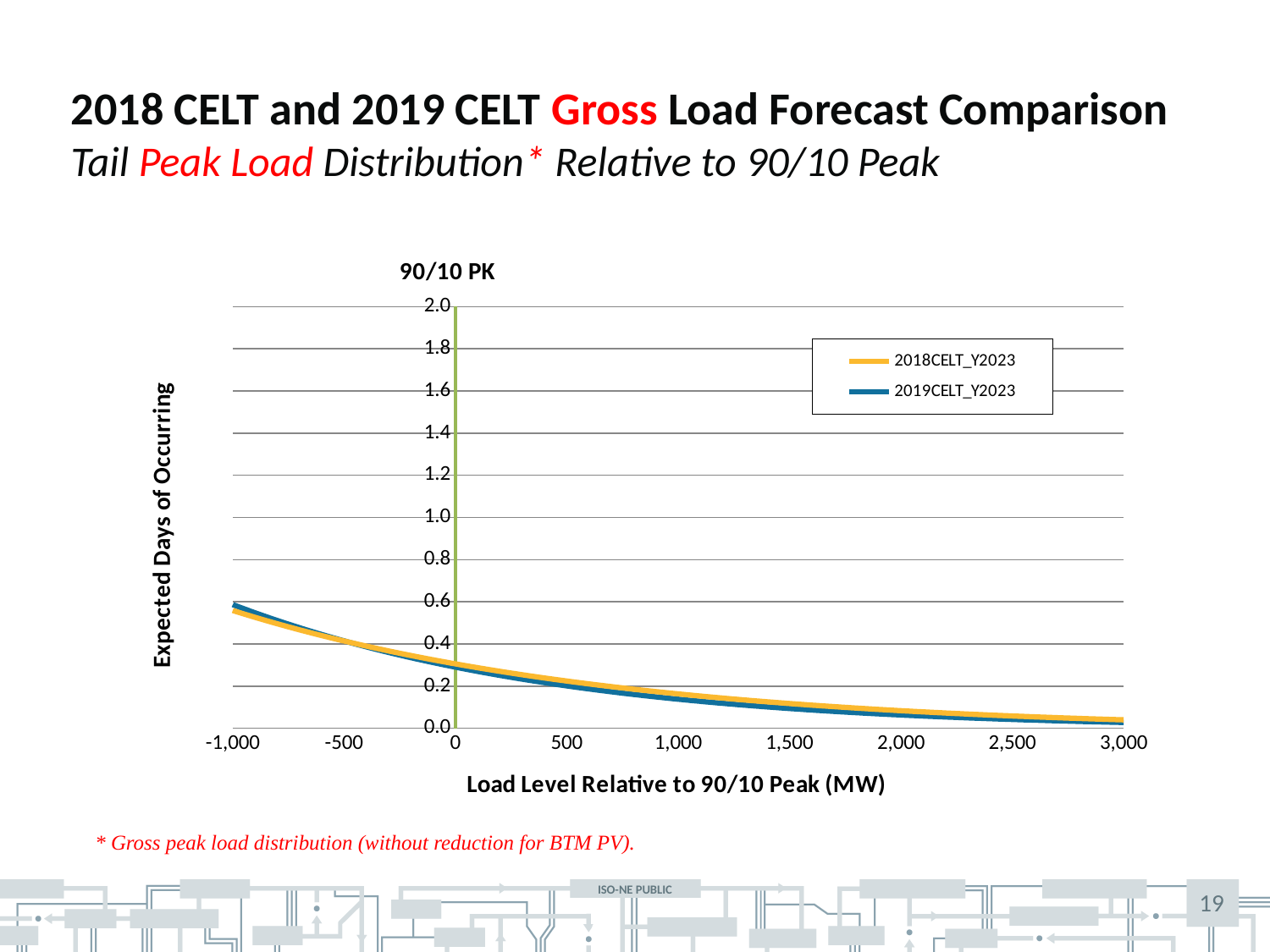
What kind of chart is shown on the slide? Line chart Which two series are listed in the legend? 2018CELT_Y2023 and 2019CELT_Y2023 Is the value for 2019CELT_Y2023 at a load level of 1,000 MW greater or less than 0.4? less Do the plotted values rise or fall as the load level increases from -1,000 to 3,000 MW? Fall Is the value for 2019CELT_Y2023 at a load level of 0 MW greater or less than 0.2? greater What is the title of the y axis? Expected Days of Occurring Is the value for 2018CELT_Y2023 at a load level of 3,000 MW greater or less than 0.2? less How many series does the legend list? 2 How many tick labels are shown on the x axis? 9